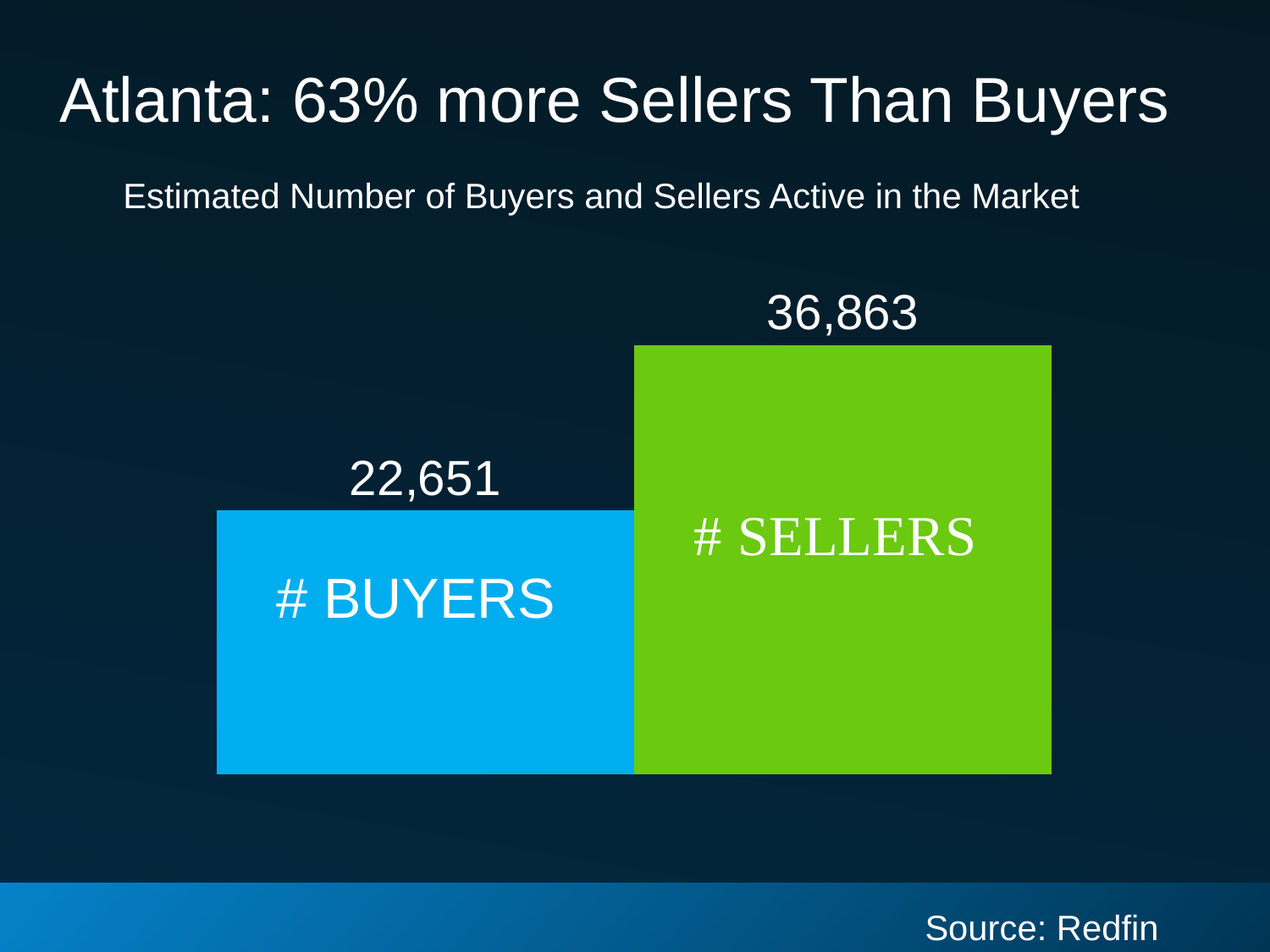
What kind of chart is shown on the slide? Bar chart What is the estimated number of buyers active in the Atlanta market? 22,651 What colour is the bar for sellers? Green How many more sellers than buyers are shown on the chart? 14,212 Is the number of buyers larger or smaller than the number of sellers? Smaller Which category has the lower value, buyers or sellers? Buyers What is the combined number of buyers and sellers shown on the chart? 59,514 Which category has the higher value, buyers or sellers? Sellers What is the subtitle of the chart? Estimated Number of Buyers and Sellers Active in the Market What is the estimated number of sellers active in the Atlanta market? 36,863 How many categories are plotted on the chart? 2